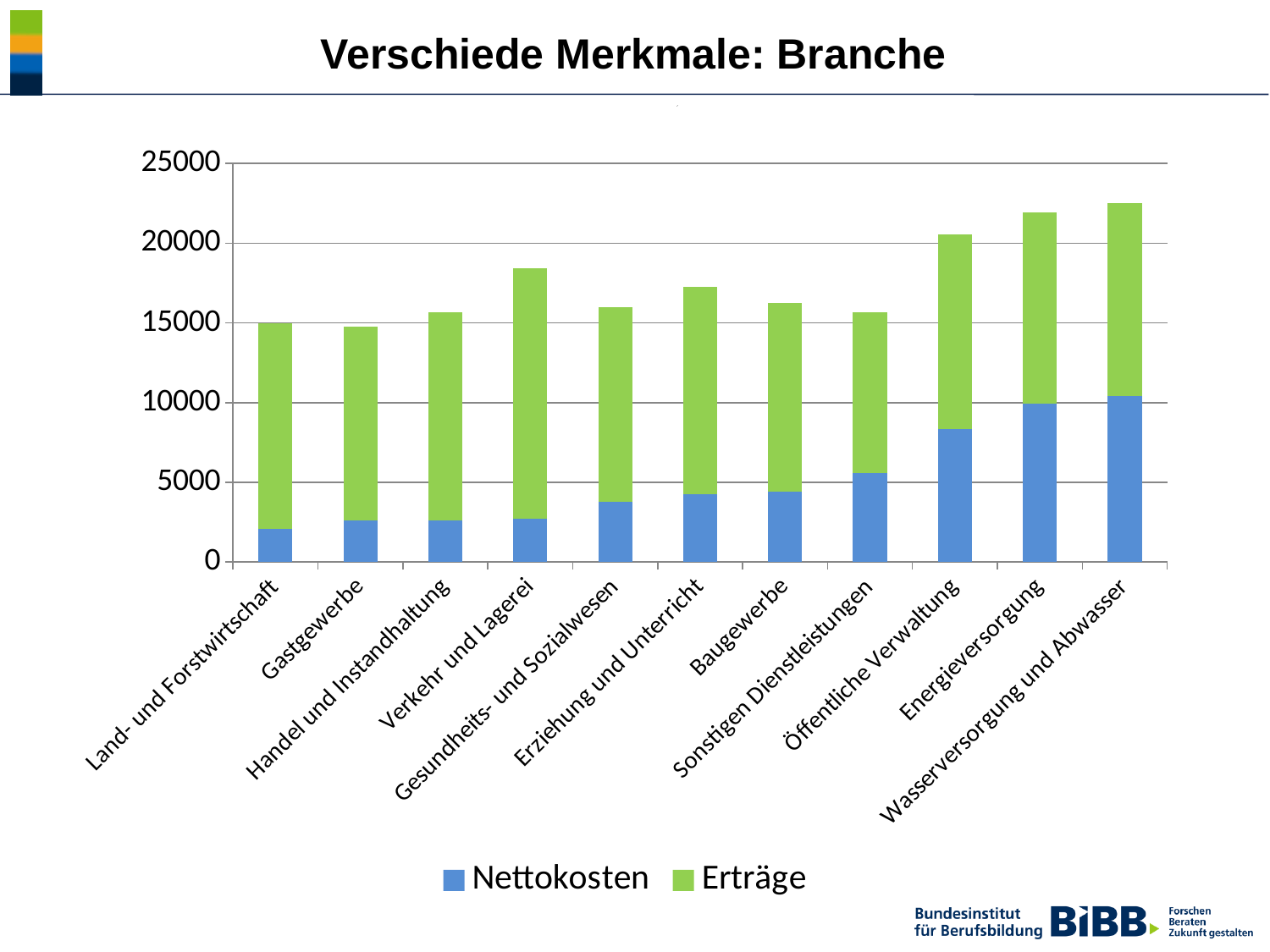
How many series does the legend list? 2 Which category has the lowest Nettokosten value? Land- und Forstwirtschaft Is the total bar for Wasserversorgung und Abwasser greater or less than 20000? greater Is the Nettokosten value for Öffentliche Verwaltung greater or less than 10000? less Do the Nettokosten values generally rise or fall from left to right along the x axis? rise Is the total bar for Verkehr und Lagerei greater or less than 20000? less Which has the larger total bar, Öffentliche Verwaltung or Baugewerbe? Öffentliche Verwaltung How many categories (Branchen) are shown on the x axis? 11 Which category has the highest total bar? Wasserversorgung und Abwasser What kind of chart is shown on the slide? Stacked bar chart Which colour represents Erträge in the chart? Green